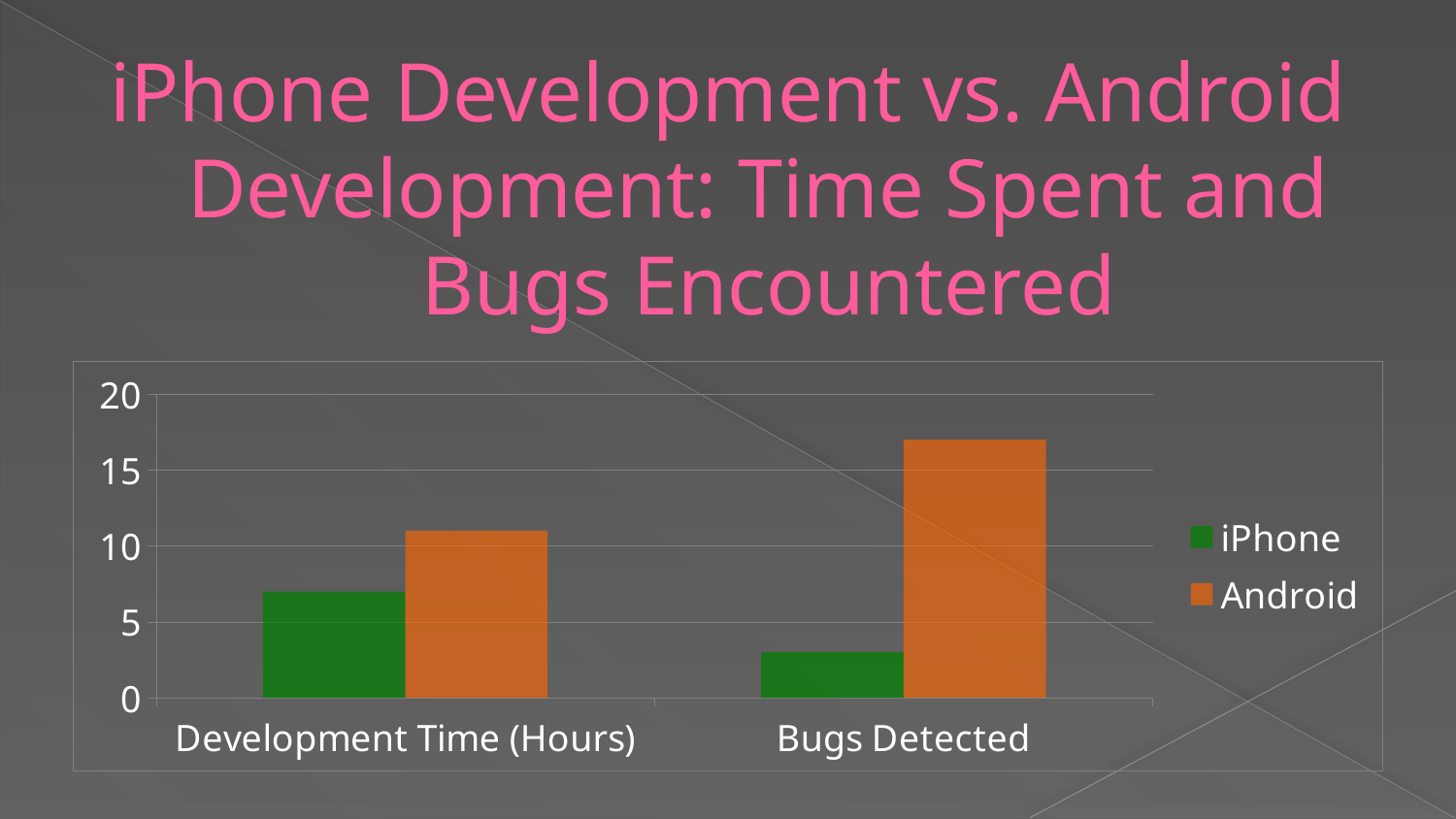
What colour represents the Android series in the legend? orange Is the Android value for Development Time (Hours) greater or less than 10? greater How many categories are shown on the x axis? 2 Is the iPhone value for Development Time (Hours) greater or less than 5? greater Which bar is the tallest in the chart? Android, Bugs Detected Which bar is the shortest in the chart? iPhone, Bugs Detected How many series does the legend list? 2 Which series has the higher value for Bugs Detected, iPhone or Android? Android Is the Android value for Bugs Detected greater or less than 15? greater What kind of chart is shown on the slide? bar chart Which series has the higher value for Development Time (Hours), iPhone or Android? Android